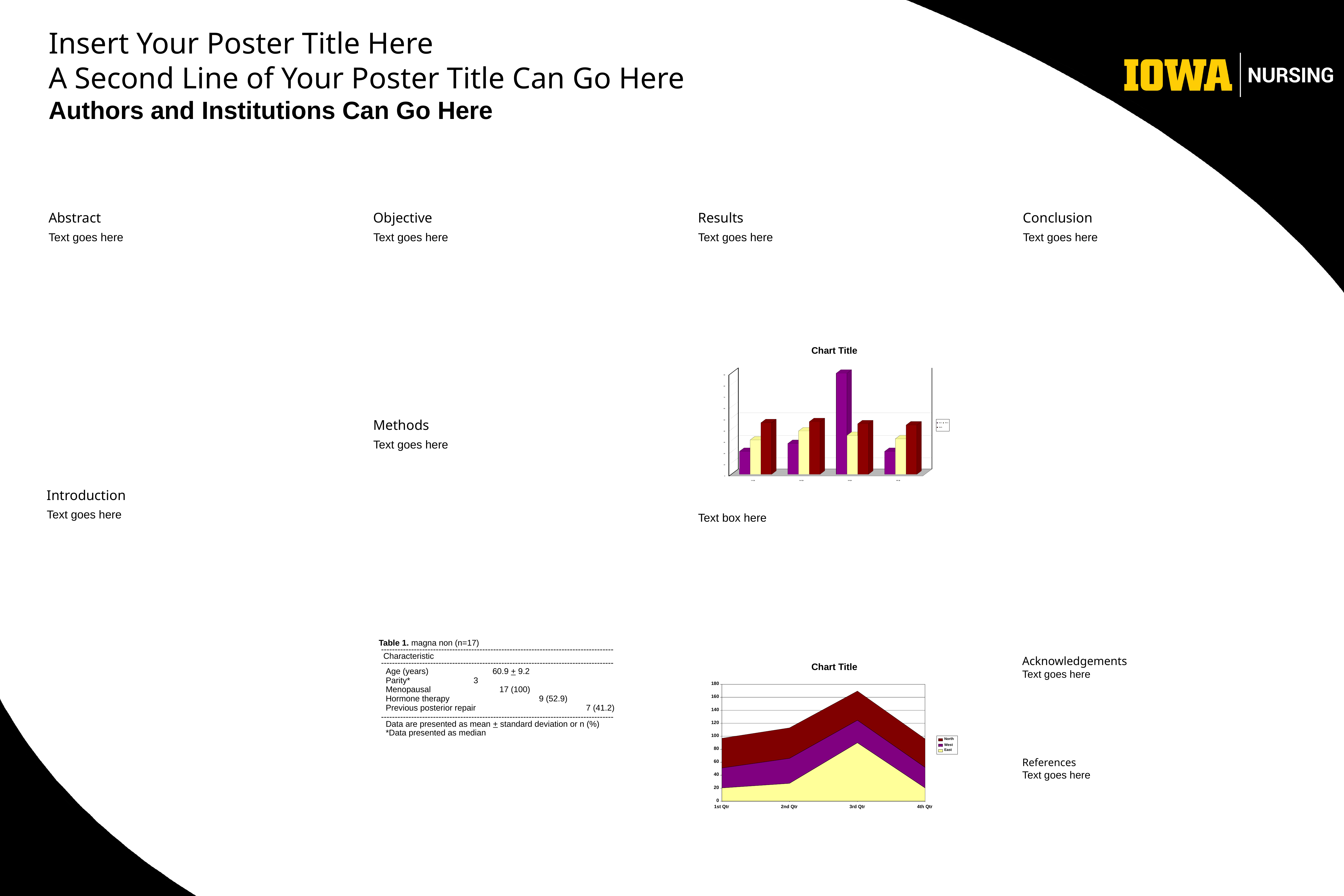
How many series does the legend of the bottom chart list? 3 In the bottom chart, is the stacked total for 3rd Qtr greater or less than 160? greater In the bottom chart, is the East value for 3rd Qtr greater or less than 80? greater What are the legend entries of the bottom chart? North, West, East What is the highest value shown on the y axis of the bottom chart? 180 In the bottom chart, which quarter has the highest stacked total? 3rd Qtr How many quarters are shown on the x axis of the bottom chart? 4 What kind of chart is the bottom chart titled 'Chart Title' on the slide? Stacked area chart In the bottom chart, is the East value for 1st Qtr greater or less than 40? less What kind of chart is the top chart on the slide? Bar chart